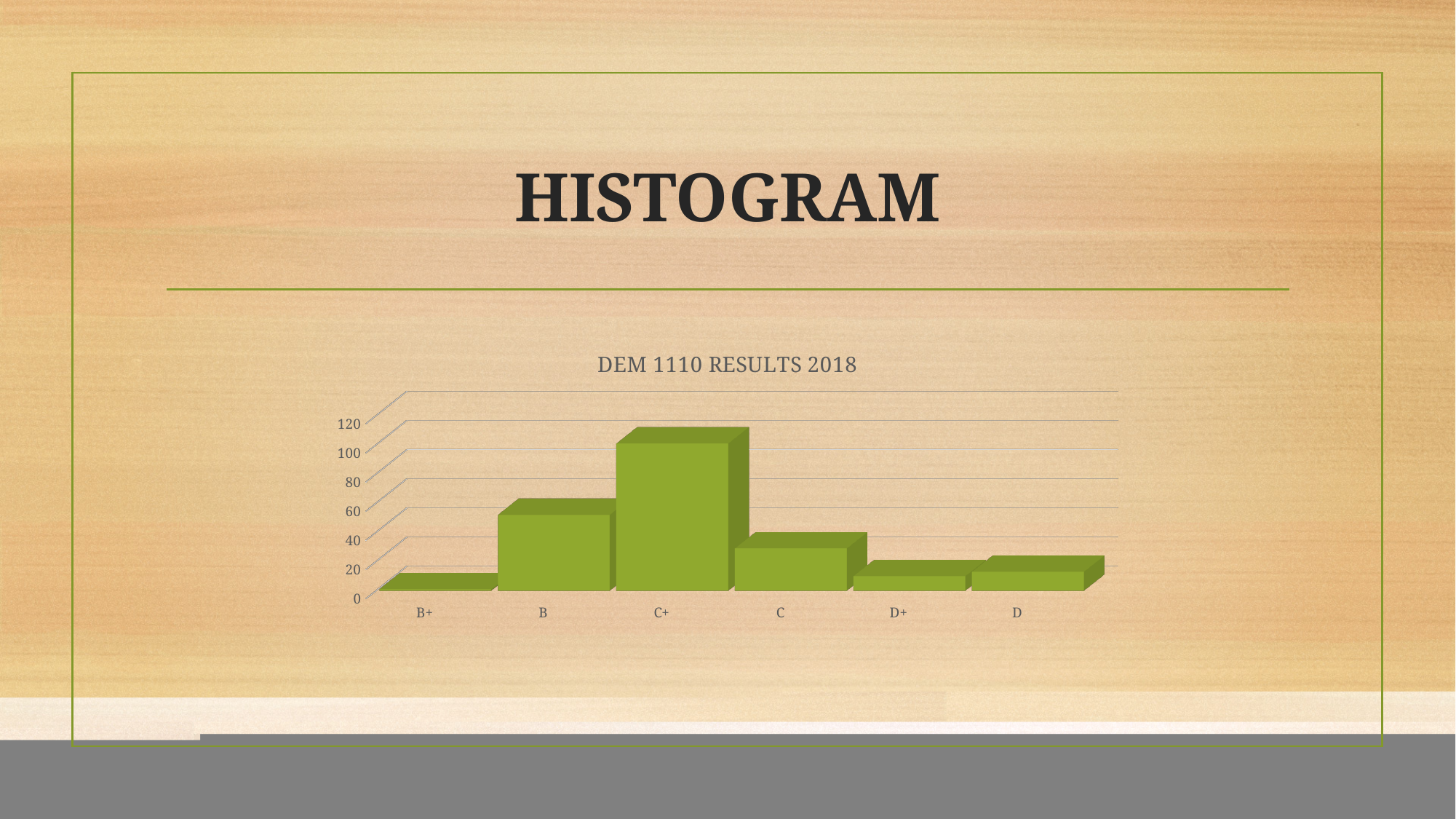
Which is larger, the value for C or the value for D? C Which is larger, the value for B or the value for C? B Is the value for D greater or less than 40? less Which grade category has the lowest value? B+ Is the value for C greater or less than 60? less Is the value for C+ greater or less than 80? greater What kind of chart is shown on the slide? bar chart How many grade categories are shown on the x axis? 6 Which grade category has the highest value? C+ What is the title of the chart? DEM 1110 RESULTS 2018